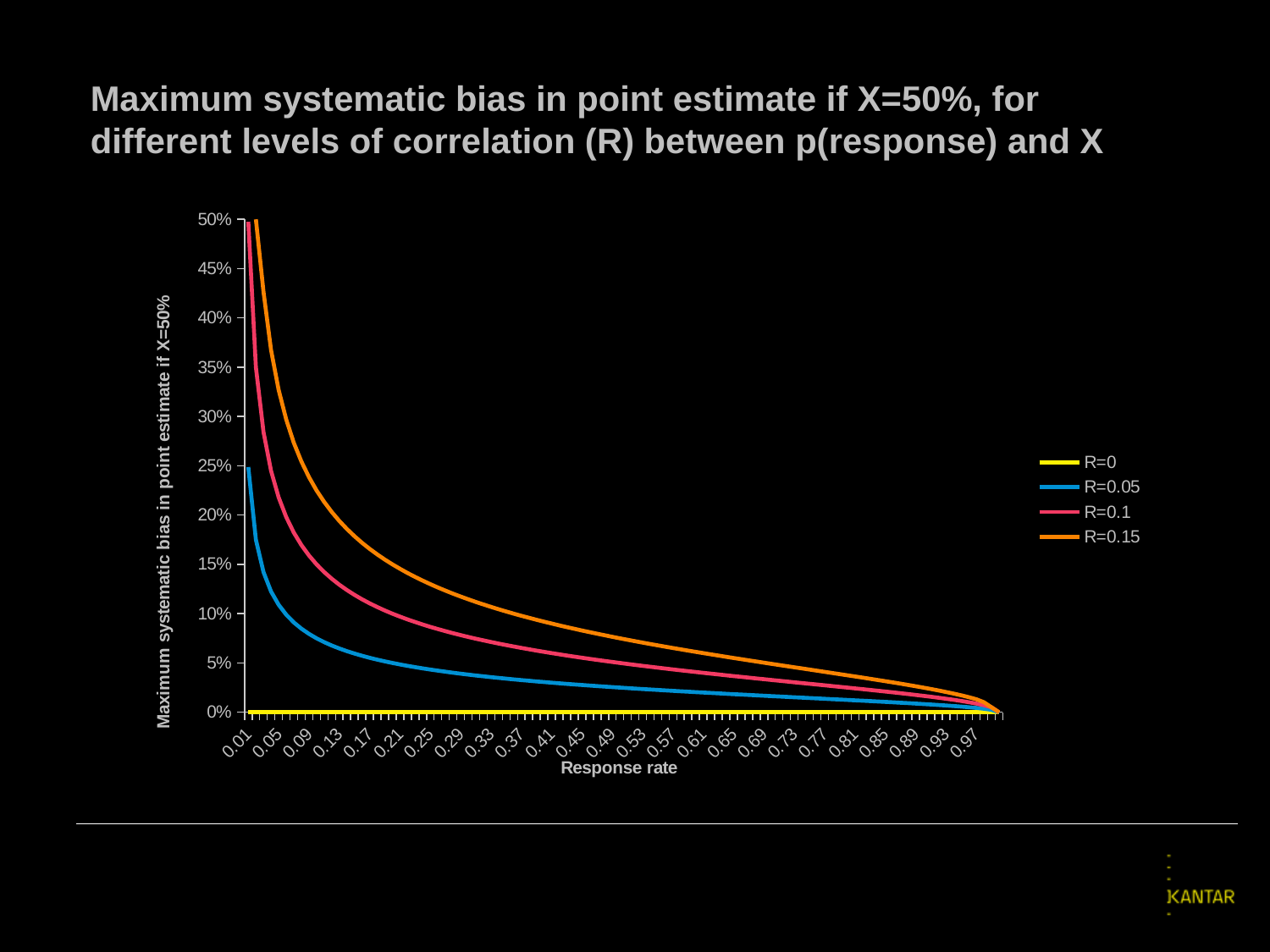
Do the values for R=0.15 rise or fall as the response rate increases? fall What value does the R=0 line take across all response rates? 0% At a response rate of 0.29, which is larger: the value for R=0.15 or the value for R=0.05? R=0.15 Is the value for R=0.15 at a response rate of 0.49 greater or less than 10%? less Which series has the highest maximum systematic bias at a response rate of 0.49? R=0.15 Which series has the lowest maximum systematic bias across all response rates? R=0 How many series does the legend list? 4 What kind of chart is shown on the slide? line chart Is the value for R=0.05 at a response rate of 0.49 greater or less than 5%? less How many response rate labels are shown on the x axis? 25 Is the value for R=0.15 at a response rate of 0.13 greater or less than 15%? greater What is the title of the x axis? Response rate